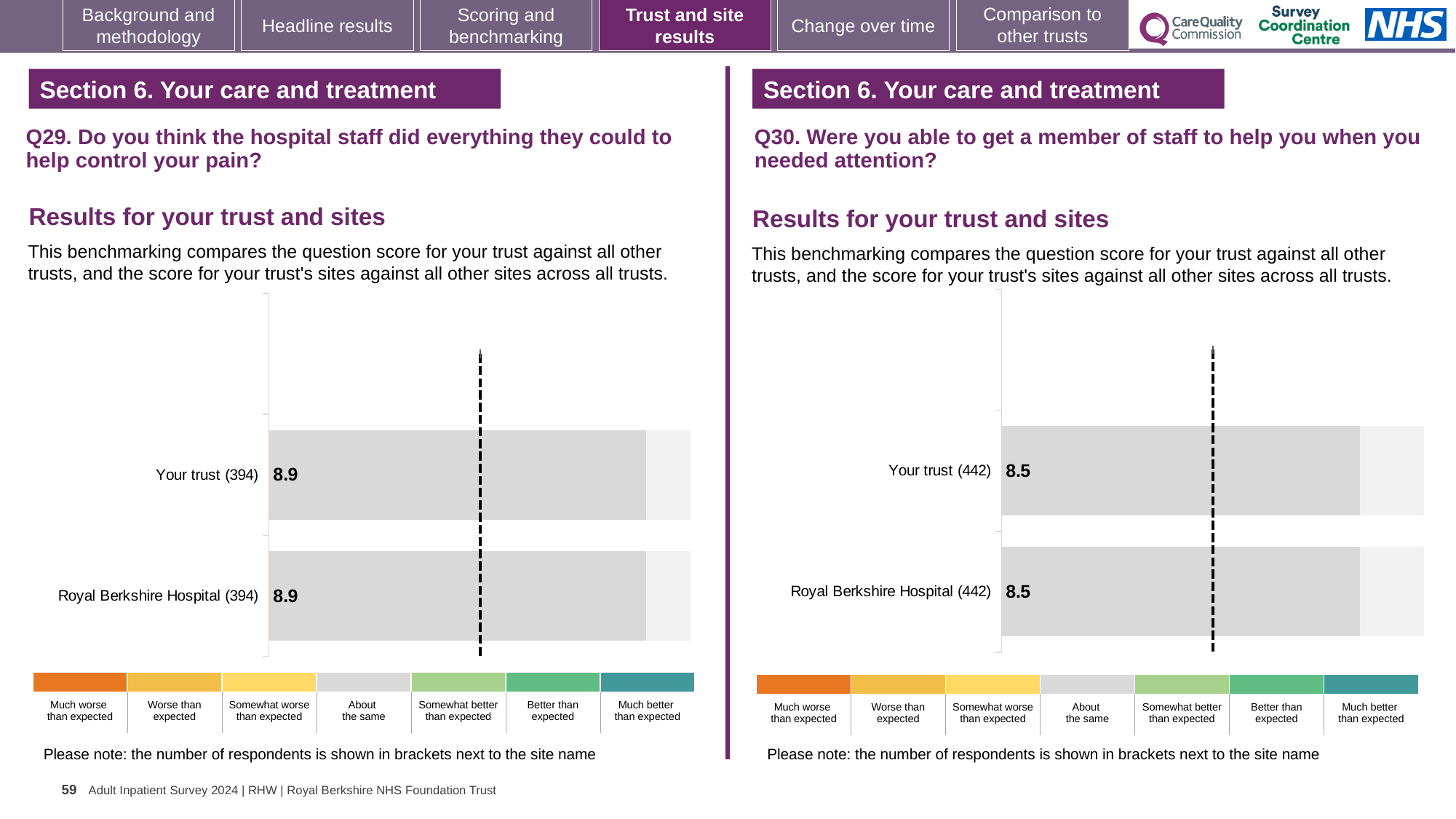
On the Q30 chart (right), what is the difference between the score for Your trust and the score for Royal Berkshire Hospital? 0 Is the score for Your trust on the Q29 chart (left) larger or smaller than the score for Your trust on the Q30 chart (right)? Larger On the Q30 chart (right), what is the score for Royal Berkshire Hospital? 8.5 On the Q30 chart (right), what is the score for Your trust? 8.5 On the Q29 chart (left), what is the score for Royal Berkshire Hospital? 8.9 On the Q30 chart (right), how many respondents are shown in brackets next to Royal Berkshire Hospital? 442 What kind of chart is the Q29 chart on the left? Bar chart On the Q29 chart (left), what is the score for Your trust? 8.9 On the Q29 chart (left), how many bars are plotted? 2 On the Q30 chart (right), how many bars are plotted? 2 On the Q29 chart (left), how many respondents are shown in brackets next to Your trust? 394 On the Q29 chart (left), what is the difference between the score for Your trust and the score for Royal Berkshire Hospital? 0